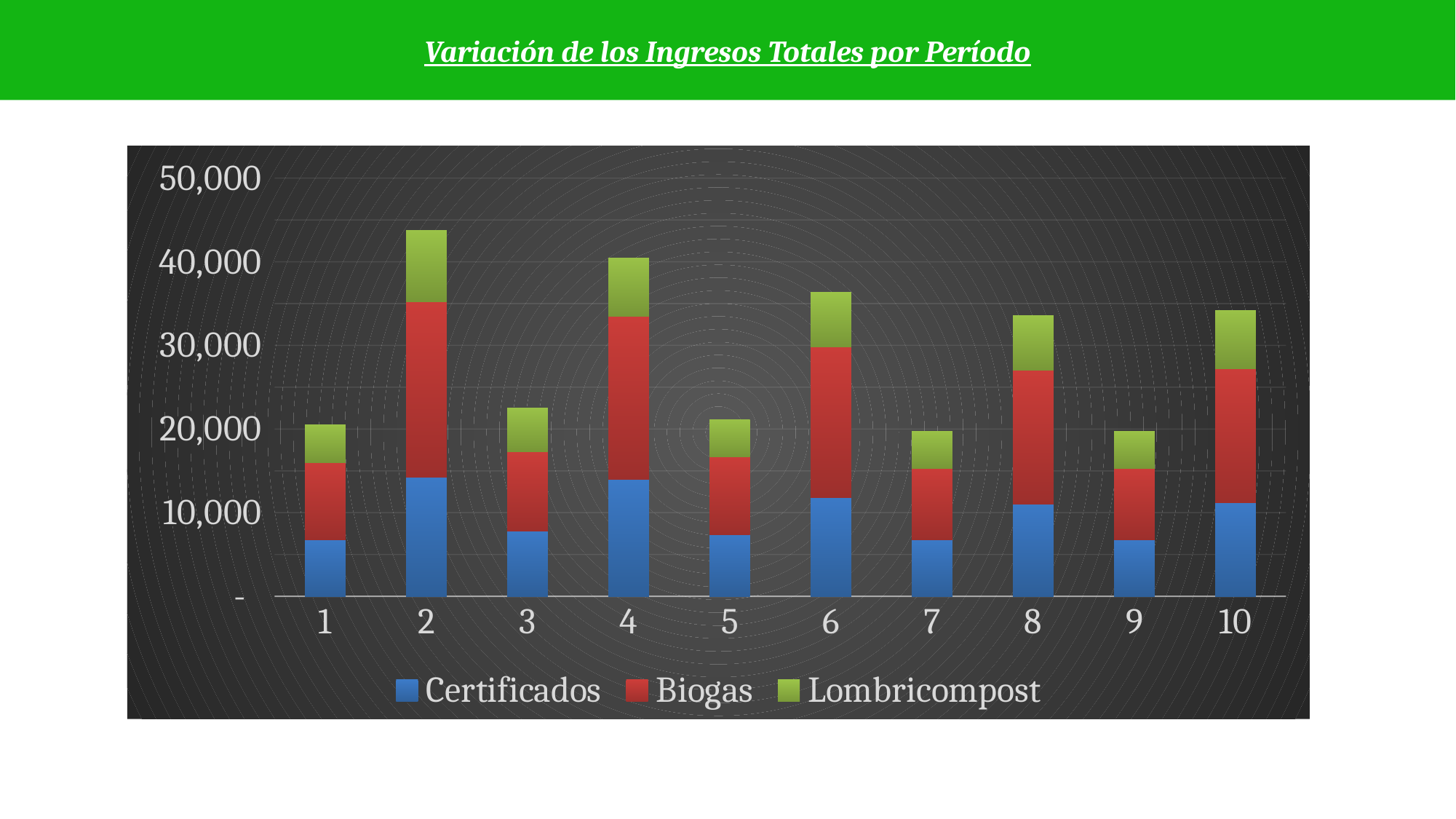
Which has the larger total bar, period 2 or period 3? Period 2 What kind of chart is shown on the slide? Stacked bar chart How many periods are shown along the x axis? 10 What is the title of the slide? Variación de los Ingresos Totales por Período Is the total for period 6 greater or less than 30,000? greater How many series does the legend list? 3 Is the total for period 8 greater or less than 40,000? less Which has the larger total bar, period 6 or period 7? Period 6 Which series is shown in red? Biogas Is the total for period 3 greater or less than 30,000? less Which period has the highest total bar? 2